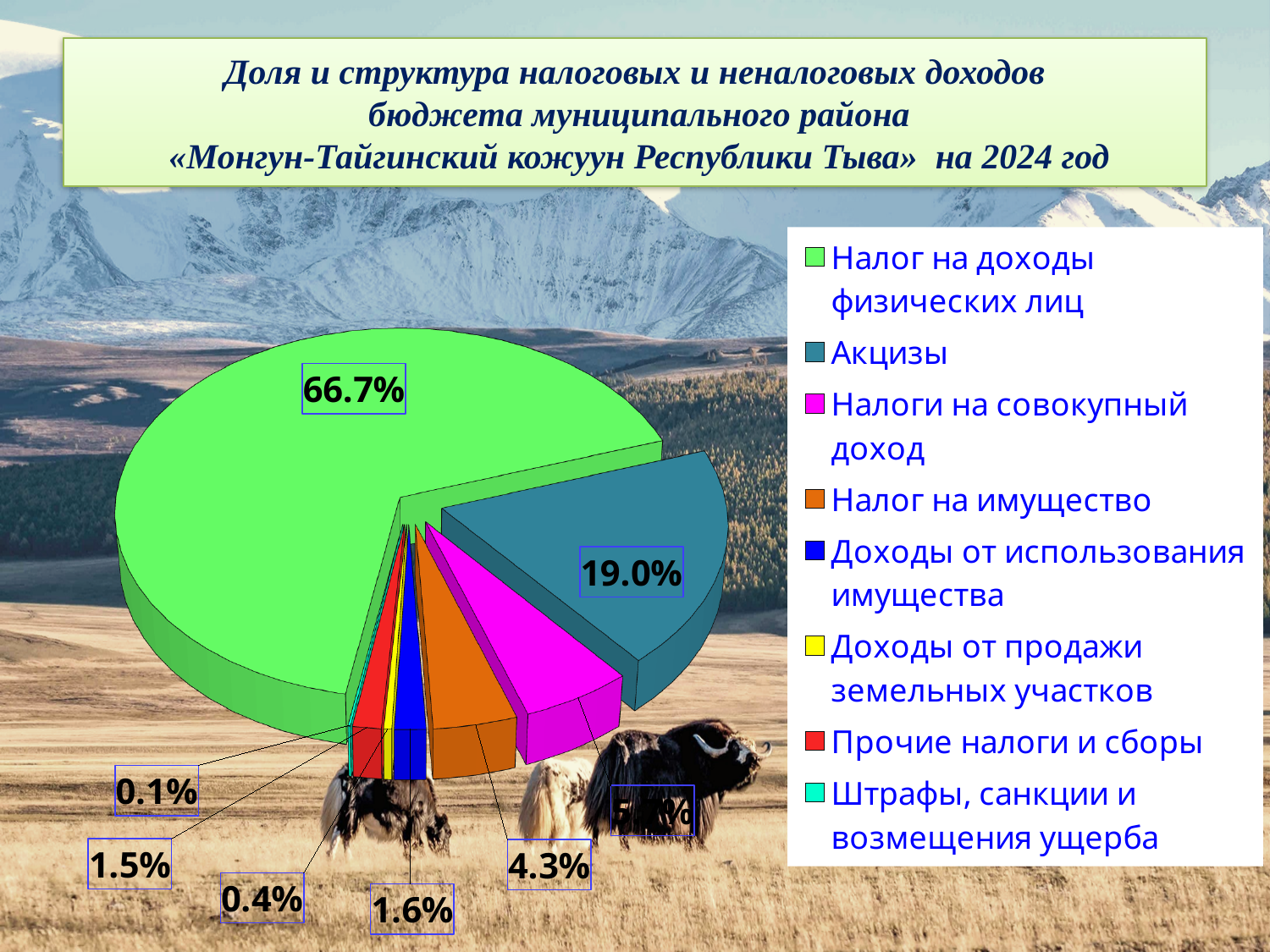
Which category has the largest share of the pie? Налог на доходы физических лиц What percentage is shown for «Налог на имущество»? 4.3% What percentage is shown for «Доходы от использования имущества»? 1.6% How many categories does the legend list? 8 What percentage is shown for «Доходы от продажи земельных участков»? 0.4% Which category has the smallest share of the pie? Штрафы, санкции и возмещения ущерба What percentage is shown for «Акцизы»? 19.0% What percentage is shown for «Прочие налоги и сборы»? 1.5% What percentage is shown for «Штрафы, санкции и возмещения ущерба»? 0.1% What type of chart is shown on the slide? Pie chart What share of the budget revenue is attributed to «Налог на доходы физических лиц»? 66.7% By how many percentage points does the share of «Налог на доходы физических лиц» exceed the share of «Акцизы»? 47.7